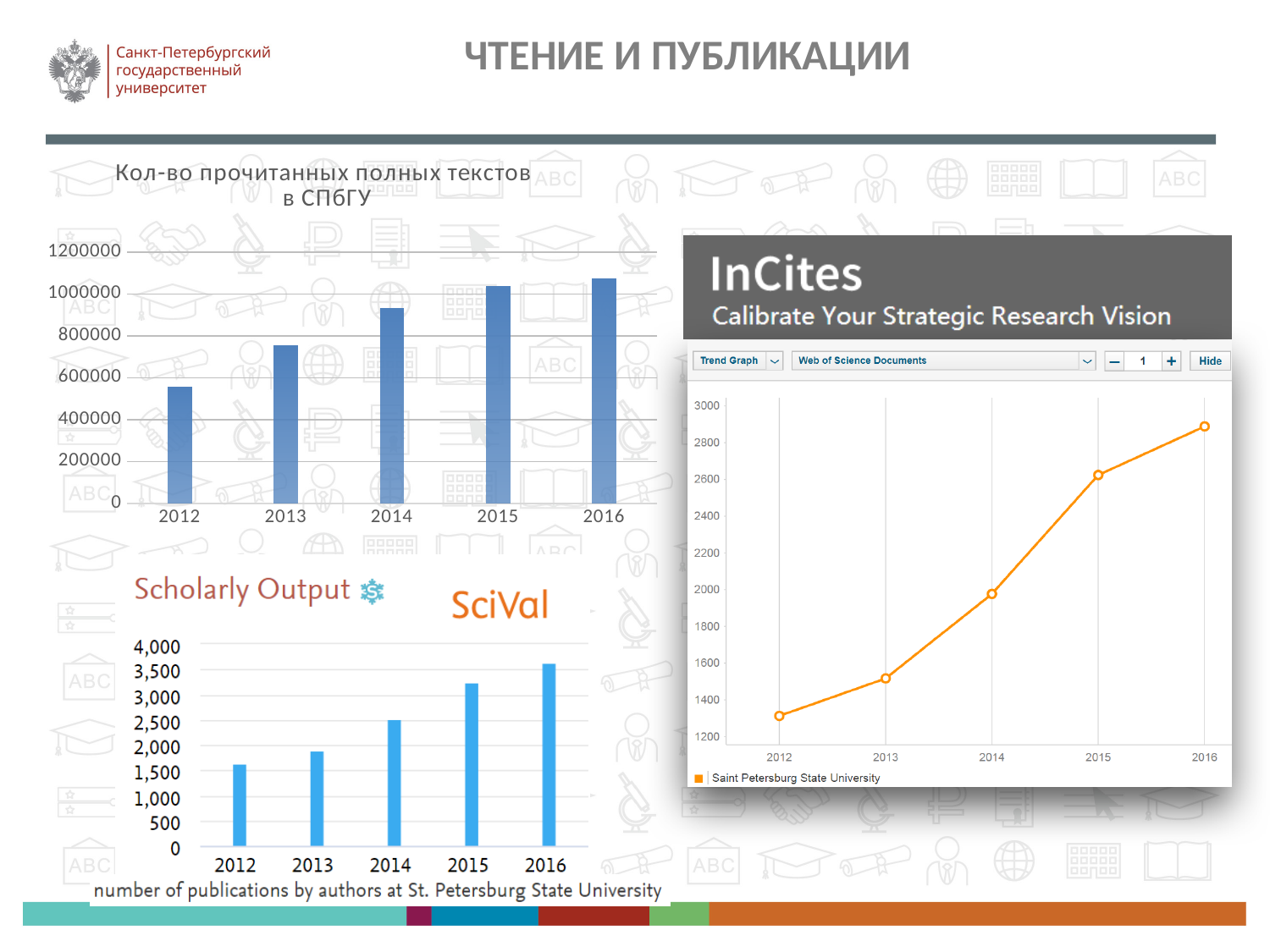
In the bottom-left 'Scholarly Output' chart, which year has the highest value? 2016 What type of chart is the top-left chart titled 'Кол-во прочитанных полных текстов в СПбГУ'? bar chart What type of chart is the InCites chart on the right? line chart How many years are shown on the x axis of the top-left chart 'Кол-во прочитанных полных текстов в СПбГУ'? 5 In the InCites line chart on the right, which institution is named in the legend? Saint Petersburg State University In the bottom-left 'Scholarly Output' chart, is the value for 2012 greater or less than 2,000? less In the bottom-left 'Scholarly Output' chart, do the values rise or fall from 2012 to 2016? rise In the top-left chart 'Кол-во прочитанных полных текстов в СПбГУ', is the value for 2015 greater or less than 1000000? greater In the top-left chart 'Кол-во прочитанных полных текстов в СПбГУ', is the value for 2012 greater or less than 600000? less In the top-left chart 'Кол-во прочитанных полных текстов в СПбГУ', which year has the lowest value? 2012